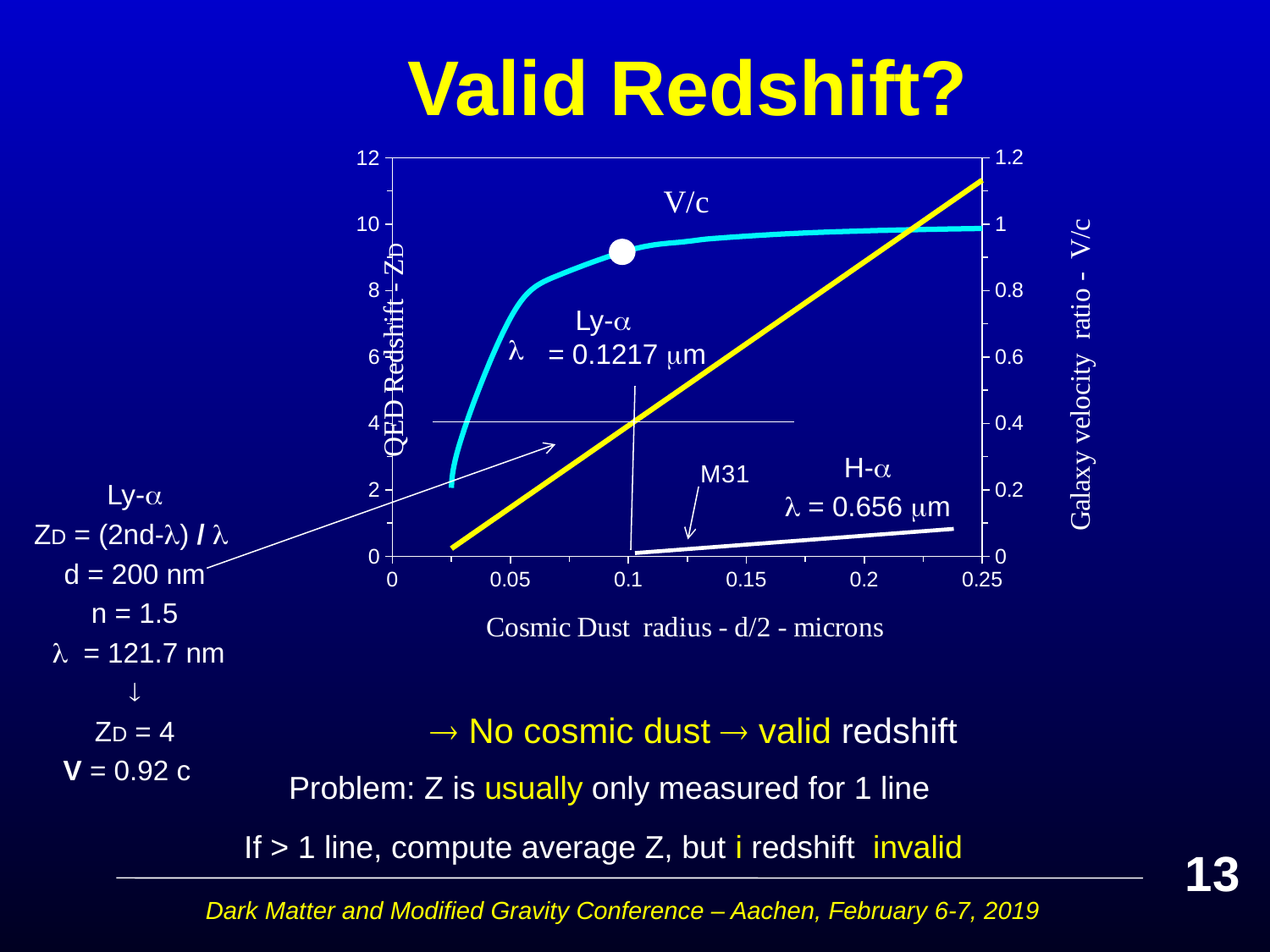
At a dust radius of 0.2 microns, which line is higher on the chart, Ly-α or H-α? Ly-α What is the label of the x axis of the chart? Cosmic Dust radius - d/2 - microns Does the H-α line rise or fall as the cosmic dust radius increases? rise Is the H-α value at a dust radius of 0.2 microns greater or less than 2 on the left axis? less What kind of chart is shown on the slide? line chart Is the V/c value at a dust radius of 0.2 microns greater or less than 0.8 on the right axis? greater Does the Ly-α line rise or fall as the cosmic dust radius increases? rise How many lines are plotted on the chart? 3 What wavelength is given for the Ly-α line on the chart? λ = 0.1217 μm Is the Ly-α value at a dust radius of 0.05 microns greater or less than 2 on the left axis? less What is the maximum value shown on the right-hand axis of the chart? 1.2